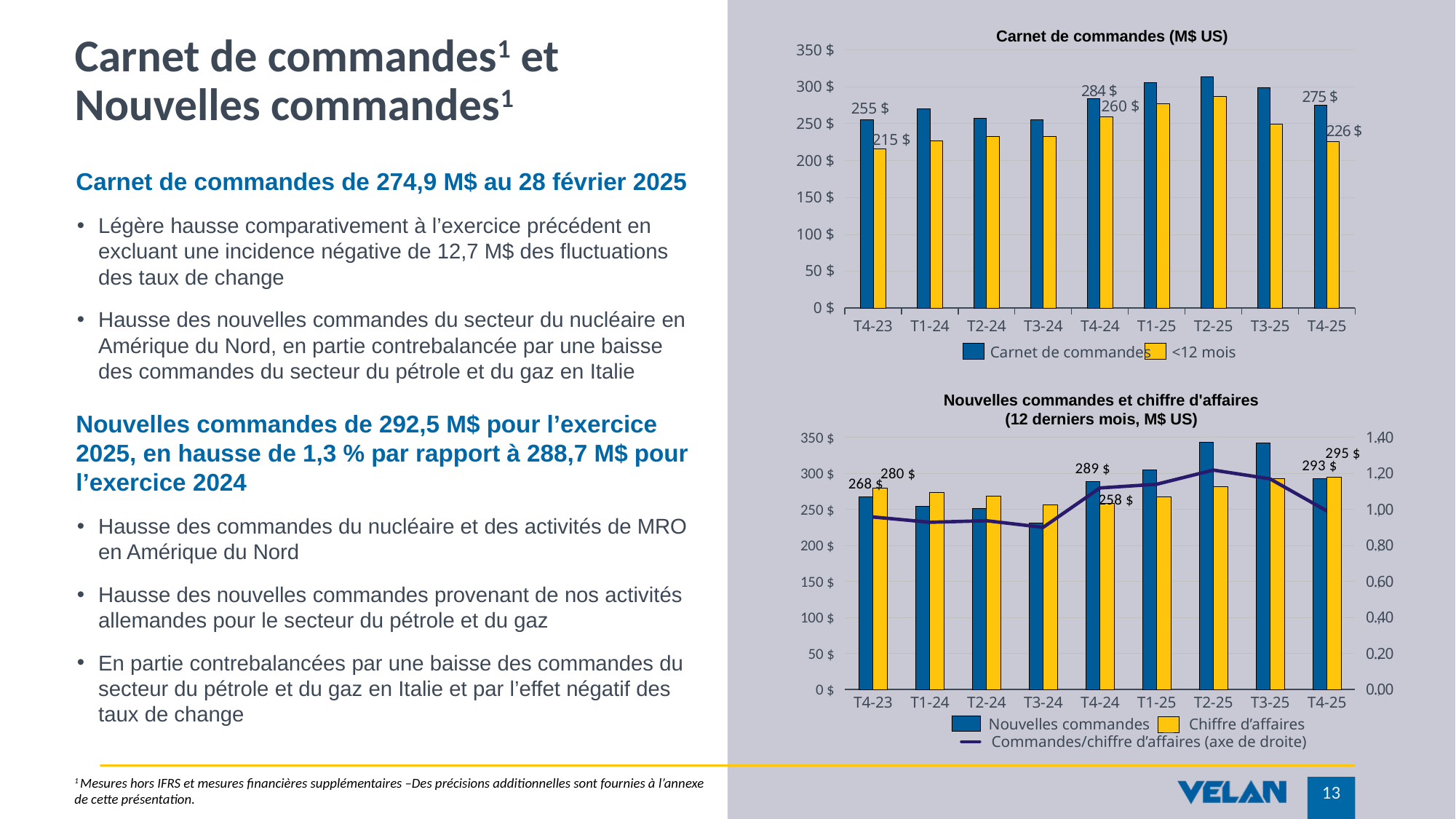
In the chart titled 'Nouvelles commandes et chiffre d'affaires', what is the value of 'Nouvelles commandes' for T4-25? 293 $ In the chart titled 'Carnet de commandes (M$ US)', in which quarter is 'Carnet de commandes' highest? T2-25 In the chart titled 'Carnet de commandes (M$ US)', what is the value of 'Carnet de commandes' for T4-24? 284 $ In the chart titled 'Nouvelles commandes et chiffre d'affaires', what is the difference between 'Nouvelles commandes' and 'Chiffre d'affaires' for T4-24? 31 $ In the chart titled 'Carnet de commandes (M$ US)', what is the value of '<12 mois' for T4-25? 226 $ In the chart titled 'Carnet de commandes (M$ US)', what is the difference between 'Carnet de commandes' and '<12 mois' for T4-23? 40 $ In the chart titled 'Nouvelles commandes et chiffre d'affaires', how many series does the legend list? 3 In the chart titled 'Carnet de commandes (M$ US)', how many series does the legend list? 2 In the chart titled 'Carnet de commandes (M$ US)', which quarter has the larger 'Carnet de commandes' value, T4-24 or T4-25? T4-24 In the chart titled 'Carnet de commandes (M$ US)', what kind of chart is shown? bar chart In the chart titled 'Carnet de commandes (M$ US)', how many quarters are shown on the x axis? 9 In the chart titled 'Carnet de commandes (M$ US)', is the 'Carnet de commandes' value for T2-25 greater or less than 300 $? greater